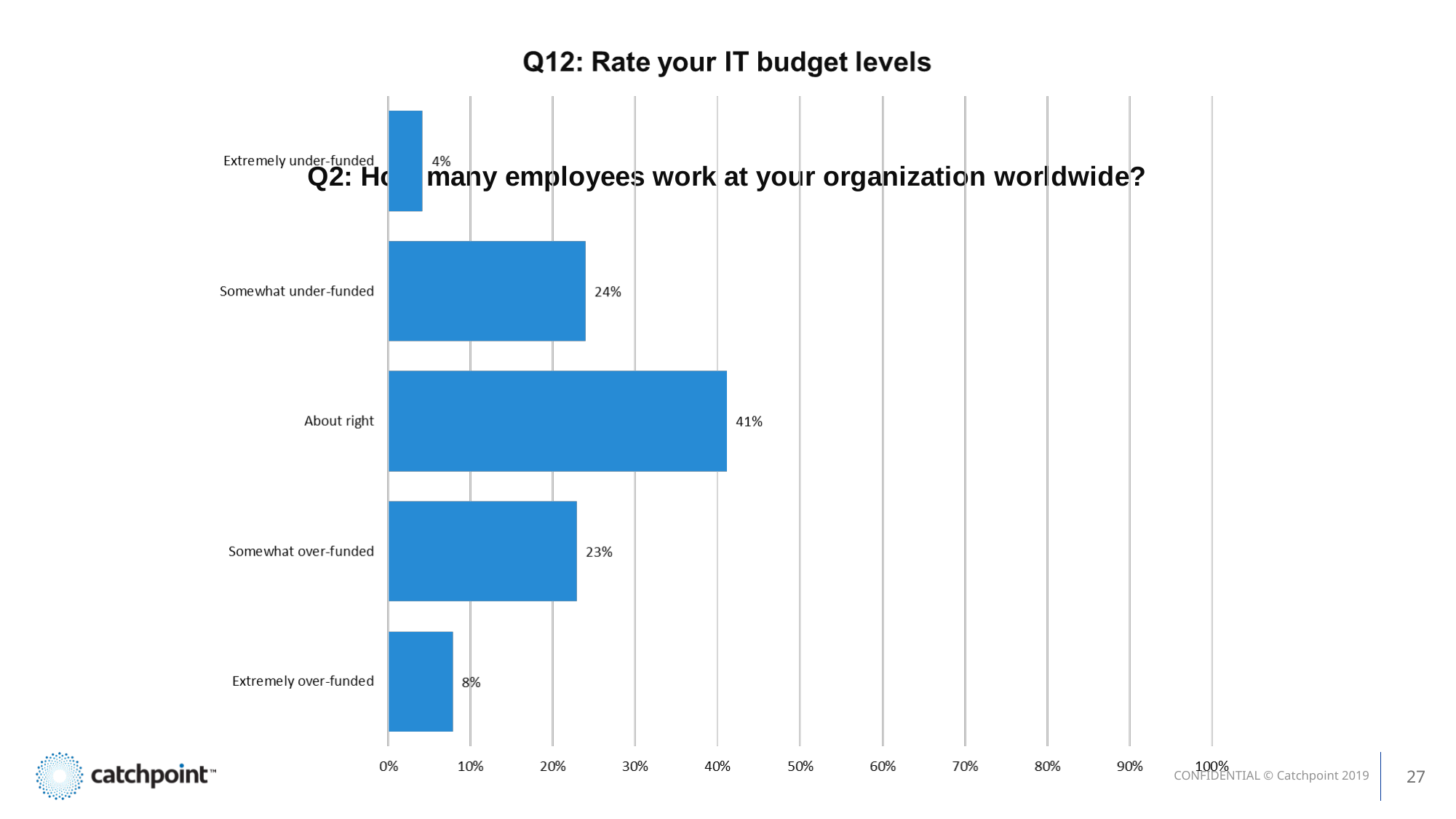
Which category has the lowest value? Extremely under-funded Which is larger, 'Somewhat under-funded' or 'Somewhat over-funded'? Somewhat under-funded Which category has the highest value? About right What is the difference between 'Extremely over-funded' and 'Extremely under-funded'? 4% What is the value for 'Somewhat under-funded'? 24% How many categories are shown in the chart? 5 What kind of chart is shown on the slide? Bar chart What is the difference between 'About right' and 'Somewhat over-funded'? 18% What percentage of respondents rated their IT budget as 'About right'? 41% Is the value for 'About right' greater or less than 50%? less What is the value for 'Extremely over-funded'? 8%